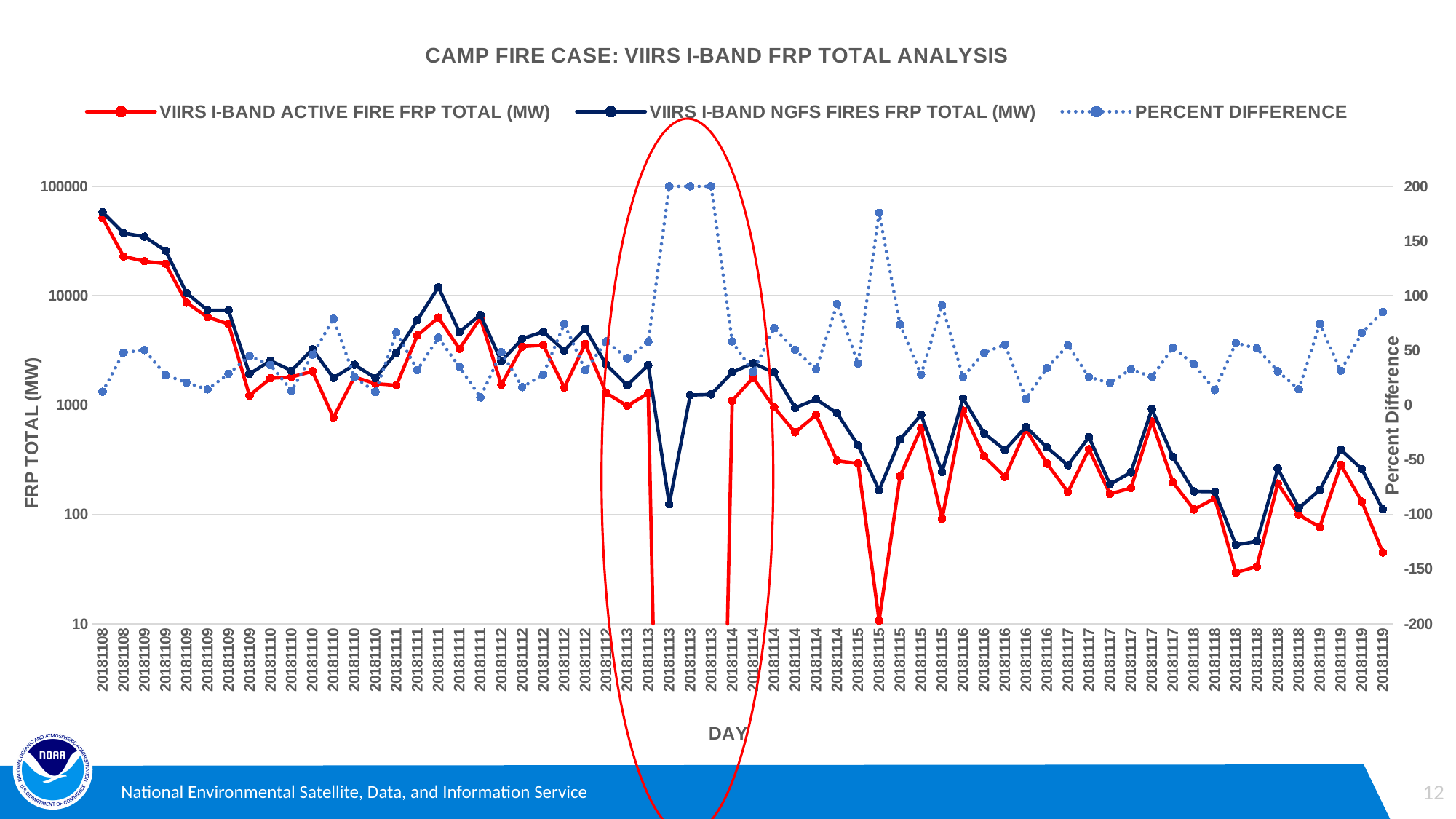
What is the title of the chart? CAMP FIRE CASE: VIIRS I-BAND FRP TOTAL ANALYSIS At the first point (20181108), which series is higher: VIIRS I-BAND ACTIVE FIRE FRP TOTAL or VIIRS I-BAND NGFS FIRES FRP TOTAL? VIIRS I-BAND NGFS FIRES FRP TOTAL (MW) Is the last value of VIIRS I-BAND ACTIVE FIRE FRP TOTAL (MW) greater or less than 100? less Is the highest PERCENT DIFFERENCE value greater or less than 150? greater Is the lowest value of VIIRS I-BAND NGFS FIRES FRP TOTAL (MW) greater or less than 1000? less How many series does the legend list? 3 Do the FRP total values generally rise or fall from 20181108 to 20181119? Fall What is the label of the left vertical axis? FRP TOTAL (MW) Which series is drawn as a dotted line? PERCENT DIFFERENCE What kind of chart is shown on the slide? Line chart